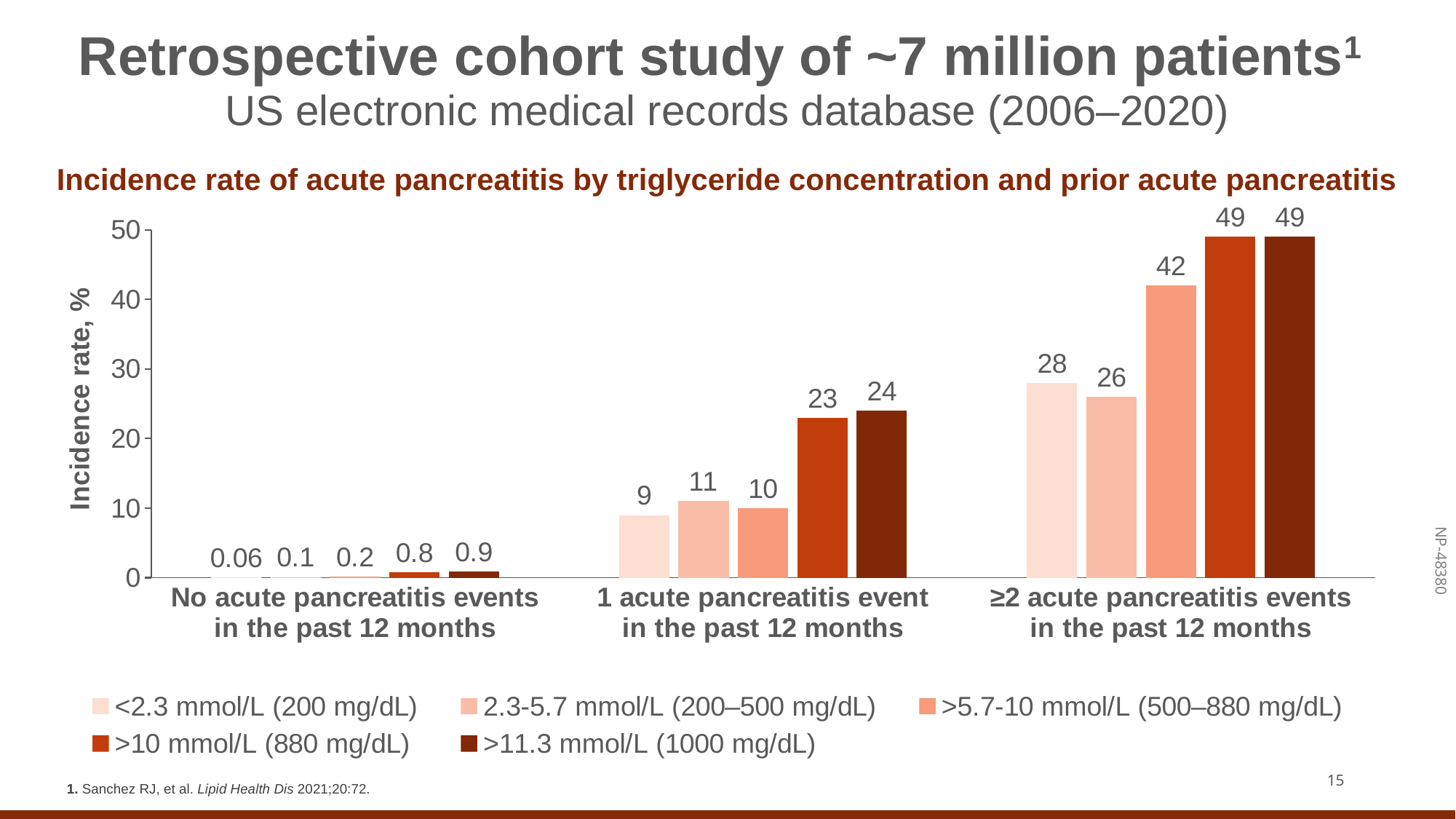
Does the incidence rate for the >10 mmol/L (880 mg/dL) group rise or fall as the number of prior acute pancreatitis events increases along the x axis? Rise How many triglyceride concentration series does the legend list? 5 What is the label of the y axis? Incidence rate, % What is the incidence rate for the >5.7-10 mmol/L (500–880 mg/dL) group among patients with ≥2 acute pancreatitis events in the past 12 months? 42 What type of chart is shown on the slide? Bar chart Which prior acute pancreatitis category has the highest incidence rate for the >11.3 mmol/L (1000 mg/dL) group? ≥2 acute pancreatitis events in the past 12 months What is the difference in incidence rate between the >11.3 mmol/L (1000 mg/dL) group and the <2.3 mmol/L (200 mg/dL) group among patients with ≥2 acute pancreatitis events? 21 Among patients with ≥2 acute pancreatitis events, which has the higher incidence rate: the <2.3 mmol/L (200 mg/dL) group or the 2.3-5.7 mmol/L (200–500 mg/dL) group? <2.3 mmol/L (200 mg/dL) What is the incidence rate for the >10 mmol/L (880 mg/dL) group among patients with 1 acute pancreatitis event in the past 12 months? 23 How many prior acute pancreatitis categories are shown on the x axis? 3 Which triglyceride group has the lowest incidence rate among patients with 1 acute pancreatitis event in the past 12 months? <2.3 mmol/L (200 mg/dL) What is the incidence rate for the <2.3 mmol/L (200 mg/dL) group among patients with no acute pancreatitis events in the past 12 months? 0.06